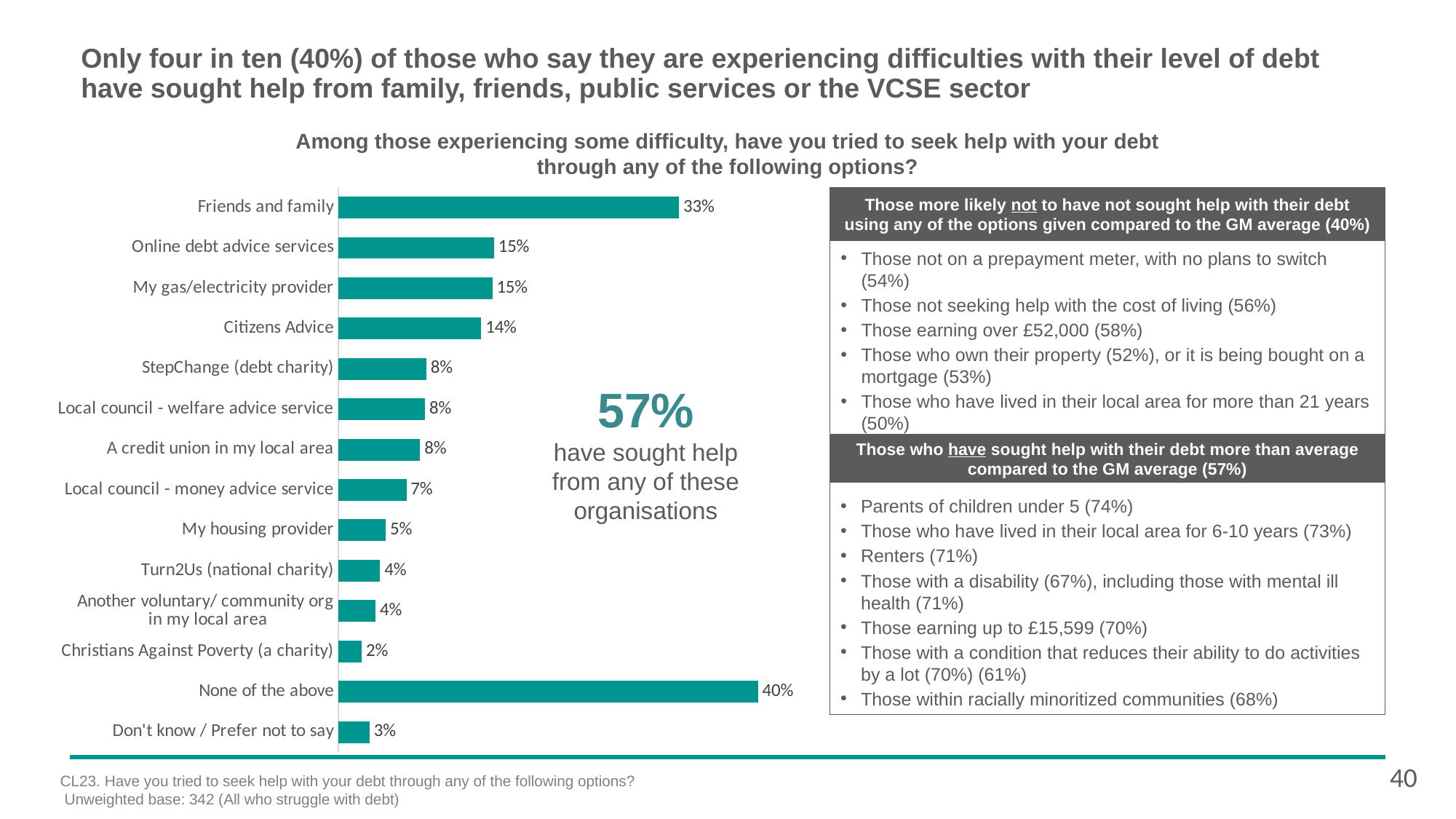
Which category has the highest value in the chart? None of the above What is the difference between the value for Online debt advice services and the value for StepChange (debt charity)? 7% What percentage sought help from their housing provider? 5% What is the difference between the value for 'None of the above' and the value for 'Friends and family'? 7% How many categories are shown in the bar chart? 14 What is the value for Christians Against Poverty (a charity)? 2% Which category has the lowest value in the chart? Christians Against Poverty (a charity) What large percentage is highlighted in the centre of the chart as having sought help from any of these organisations? 57% What type of chart is shown on the slide? Bar chart What percentage of respondents sought help from friends and family? 33% What is the value shown for Citizens Advice? 14% Which is larger: the value for Citizens Advice or the value for Turn2Us (national charity)? Citizens Advice